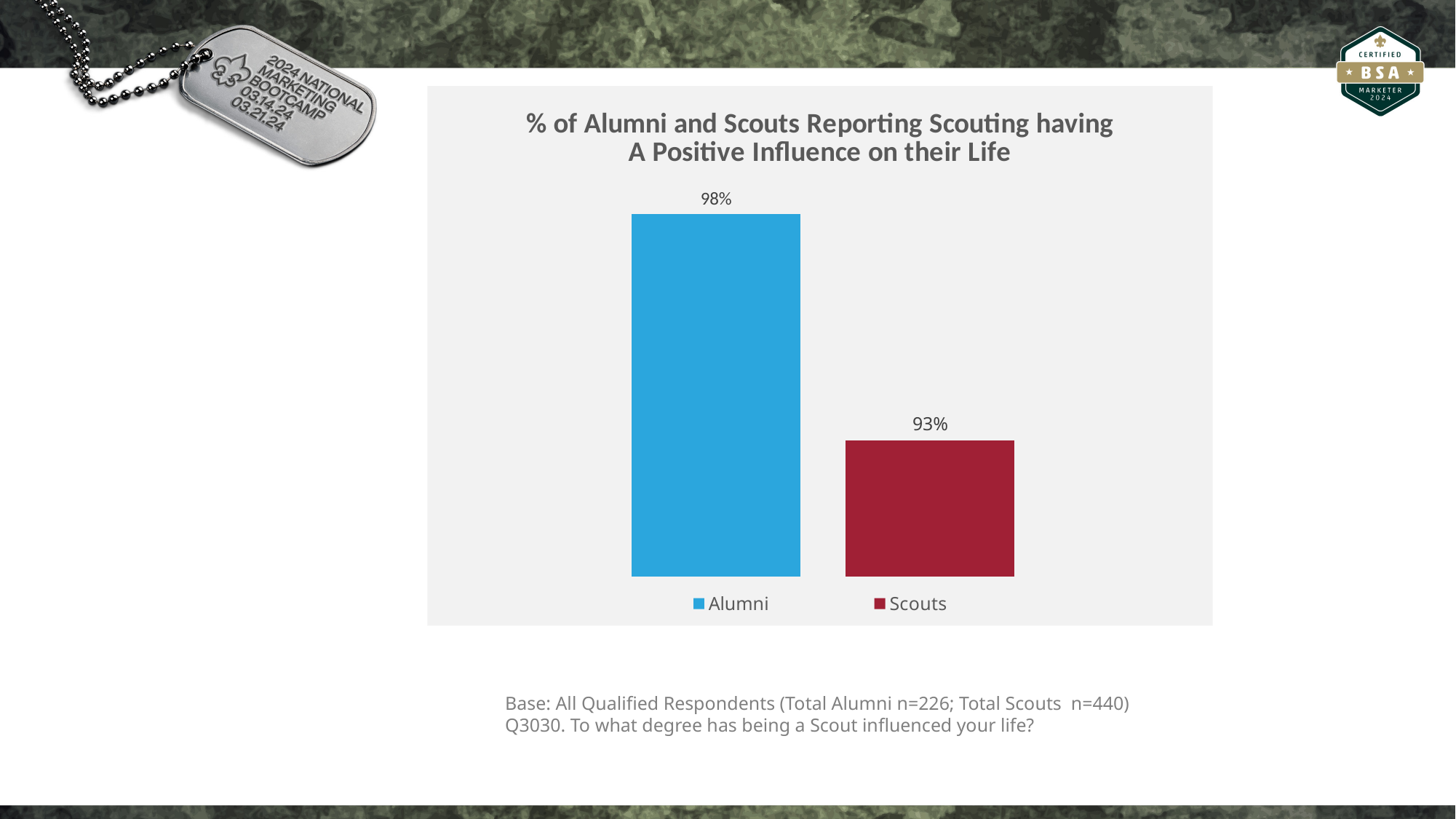
Which group has the lower percentage reporting a positive influence? Scouts Is the value for Scouts larger or smaller than the value for Alumni? smaller What is the title of the chart? % of Alumni and Scouts Reporting Scouting having A Positive Influence on their Life What percentage of Alumni report Scouting having a positive influence on their life? 98% What type of chart is shown on the slide? bar chart Which group has the higher percentage reporting a positive influence, Alumni or Scouts? Alumni How many bars are shown in the chart? 2 What is the difference in percentage points between Alumni and Scouts? 5 percentage points How many series does the legend list? 2 What colour is the Scouts bar? red What percentage of Scouts report Scouting having a positive influence on their life? 93%